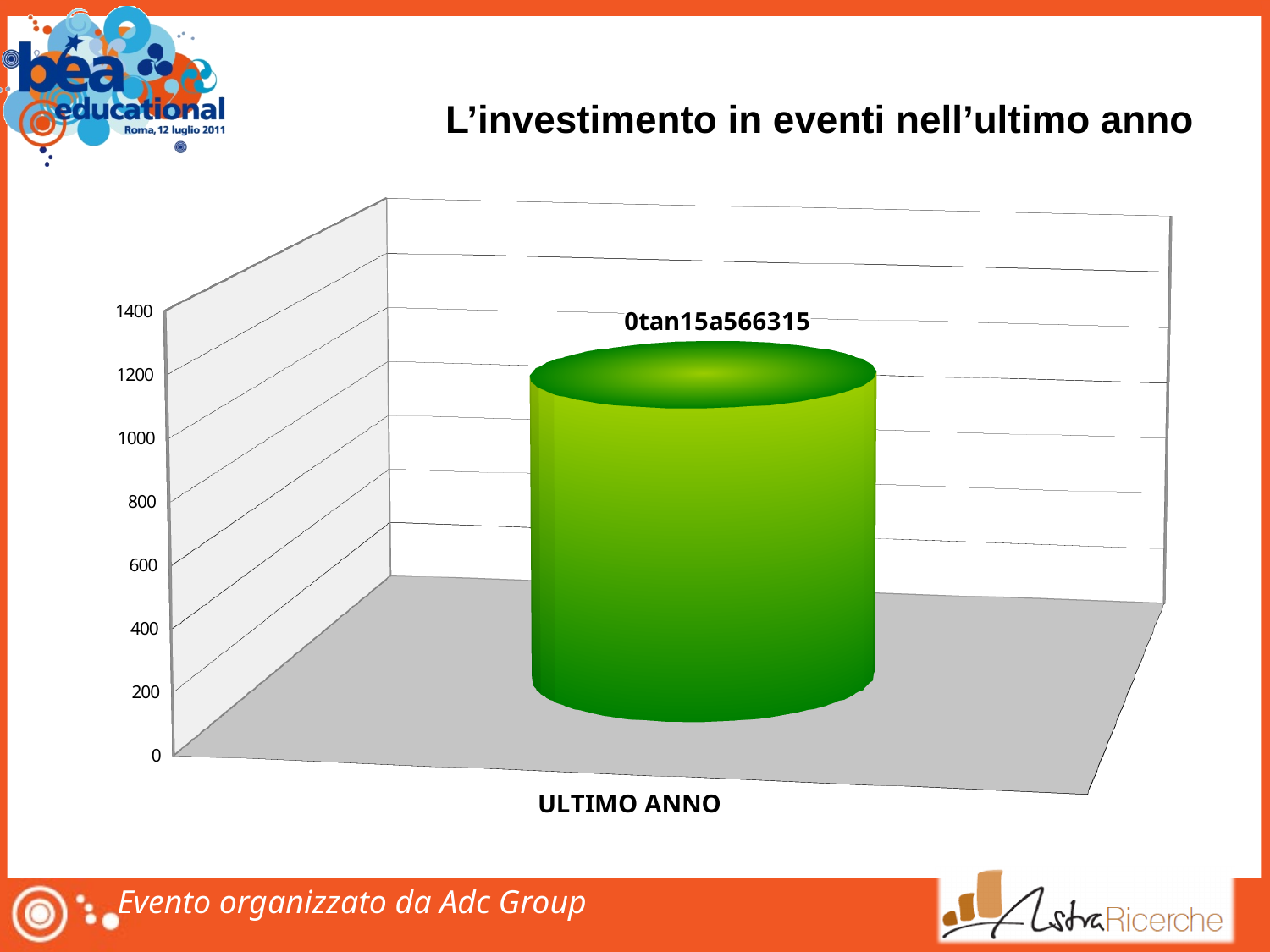
Is the value for ULTIMO ANNO greater or less than 1000? greater How many categories are plotted on the chart? 1 What is the label of the single category on the x axis? ULTIMO ANNO Is the value for ULTIMO ANNO greater or less than 800? greater What kind of chart is shown on the slide? bar chart Is the value for ULTIMO ANNO greater or less than 1400? less What is the title of the chart on the slide? L'investimento in eventi nell'ultimo anno What is the highest tick value shown on the vertical axis? 1400